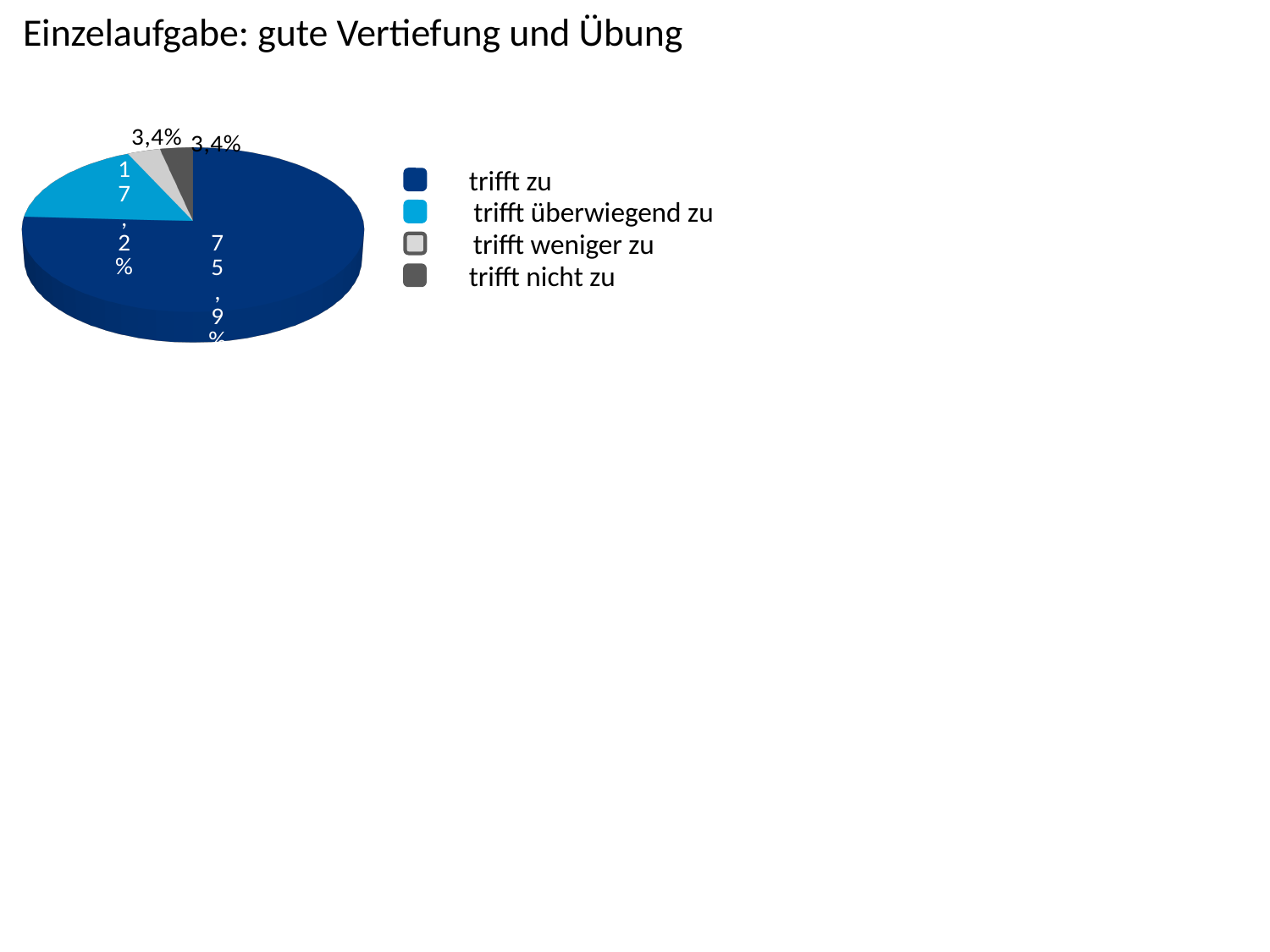
What share of the pie does "trifft überwiegend zu" have? 17,2% Which is larger, the share of "trifft überwiegend zu" or the share of "trifft weniger zu"? trifft überwiegend zu What is the title of the chart on the slide? Einzelaufgabe: gute Vertiefung und Übung What share of the pie does "trifft weniger zu" have? 3,4% What share of the pie does "trifft nicht zu" have? 3,4% Which category has the largest slice of the pie? trifft zu Which legend entry is shown in light blue? trifft überwiegend zu How many slices does the pie chart have? 4 How many entries does the legend list? 4 What kind of chart is shown on the slide? pie chart What is the difference between the shares of "trifft zu" and "trifft überwiegend zu"? 58,7%